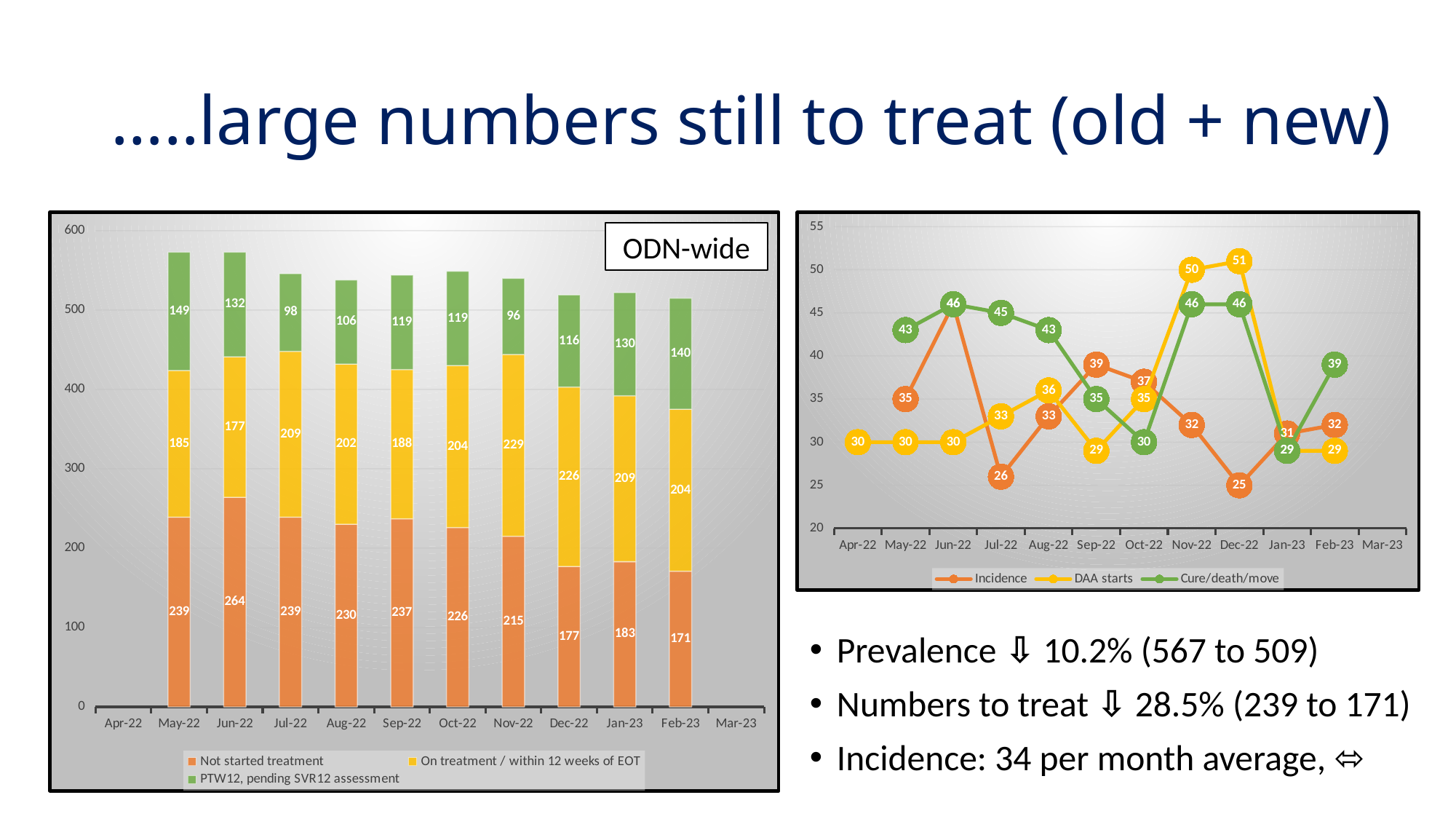
In the left stacked bar chart (ODN-wide), what is the difference between the 'Not started treatment' values for May-22 and Feb-23? 68 In the right line chart, what is the difference between DAA starts and Incidence in Nov-22? 18 What kind of chart is the chart on the right of the slide? Line chart In the right line chart, which month has the highest DAA starts value? Dec-22 In the left stacked bar chart (ODN-wide), what is the value for 'Not started treatment' in Jun-22? 264 In the left stacked bar chart (ODN-wide), what is the total of the stacked bar for Feb-23? 515 In the left stacked bar chart (ODN-wide), which month has the highest 'Not started treatment' value? Jun-22 In the right line chart, which is larger in Sep-22: Incidence or Cure/death/move? Incidence In the left stacked bar chart (ODN-wide), which month has the lowest 'PTW12, pending SVR12 assessment' value? Nov-22 In the left stacked bar chart (ODN-wide), how many series does the legend list? 3 In the right line chart, what is the Incidence value for Dec-22? 25 In the left stacked bar chart (ODN-wide), what is the value for 'PTW12, pending SVR12 assessment' in Feb-23? 140